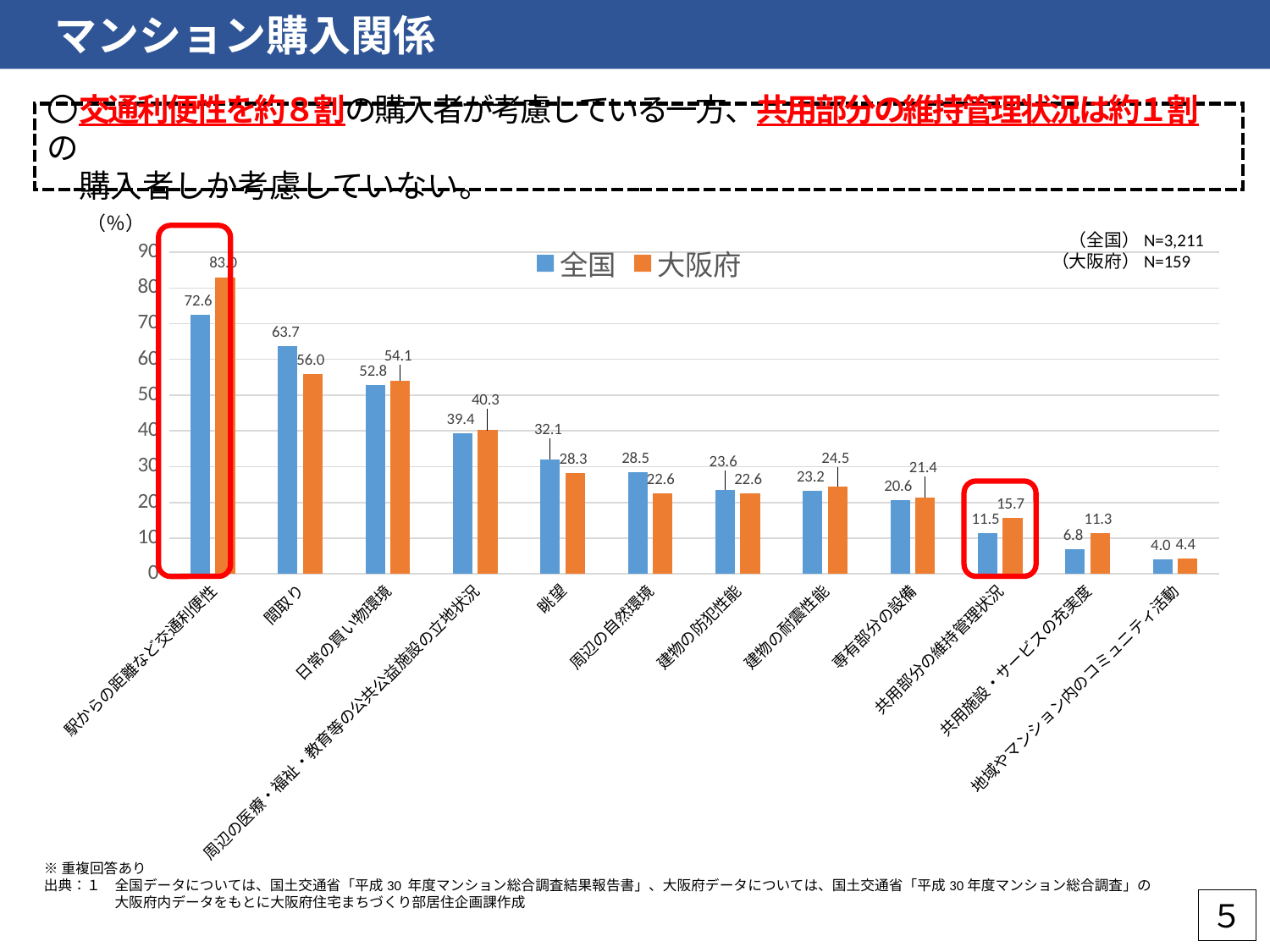
What kind of chart is shown on the slide? bar chart What is the 大阪府 value for 共用部分の維持管理状況? 15.7 How many categories are shown on the x axis? 12 What is the 大阪府 value for 共用施設・サービスの充実度? 11.3 For 共用部分の維持管理状況, which is larger, the 全国 value or the 大阪府 value? 大阪府 What is the 全国 value for 眺望? 32.1 What is the difference between the 全国 and 大阪府 values for 間取り? 7.7 Which category has the highest 全国 value? 駅からの距離など交通利便性 How many series does the legend list? 2 Which category has the lowest 全国 value? 地域やマンション内のコミュニティ活動 Is the 大阪府 value for 駅からの距離など交通利便性 greater or less than 80? greater What is the 全国 value for 間取り? 63.7